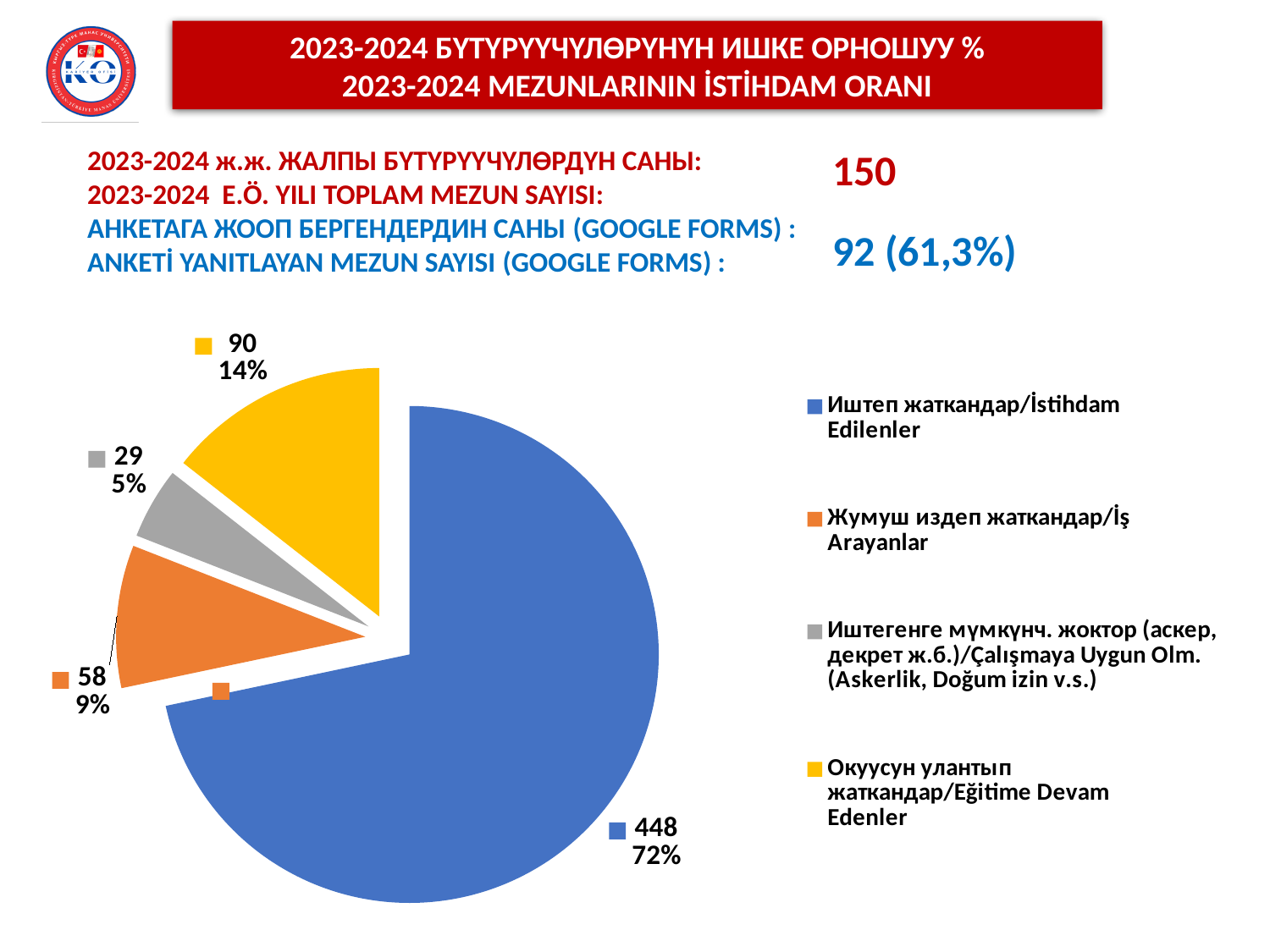
Which colour represents Окуусун улантып жаткандар/Eğitime Devam Edenler in the pie chart? yellow Which category has the largest slice in the pie chart? Иштеп жаткандар/İstihdam Edilenler What is the value for Окуусун улантып жаткандар/Eğitime Devam Edenler in the pie chart? 90 What kind of chart is shown on the slide? pie chart What is the difference between the values for Окуусун улантып жаткандар/Eğitime Devam Edenler and Жумуш издеп жаткандар/İş Arayanlar? 32 How many slices does the pie chart have? 4 What is the value for Иштеп жаткандар/İstihdam Edilenler in the pie chart? 448 What is the value for Жумуш издеп жаткандар/İş Arayanlar in the pie chart? 58 What share of the pie does Иштеп жаткандар/İstihdam Edilenler represent? 72% What share of the pie does Иштегенге мүмкүнч. жоктор/Çalışmaya Uygun Olm. represent? 5% Which category has the smallest slice in the pie chart? Иштегенге мүмкүнч. жоктор/Çalışmaya Uygun Olm. How many entries does the legend of the pie chart list? 4